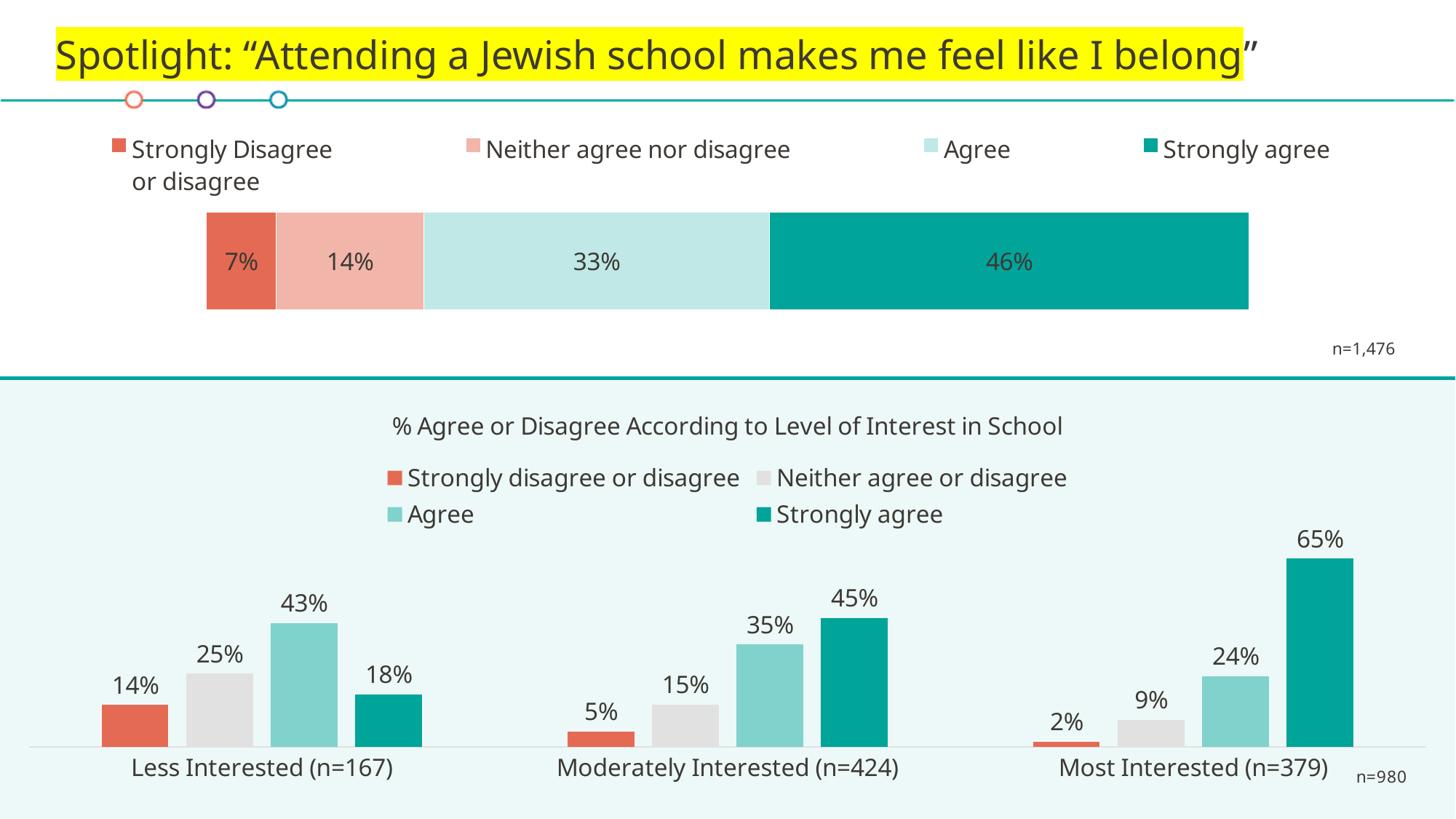
In the chart '% Agree or Disagree According to Level of Interest in School', what is the difference between the 'Strongly agree' percentages of the Most Interested and Less Interested groups? 47% In the chart '% Agree or Disagree According to Level of Interest in School', which interest group has the lowest 'Strongly disagree or disagree' percentage? Most Interested (n=379) In the top stacked bar chart, what percentage of respondents said 'Neither agree nor disagree'? 14% In the chart '% Agree or Disagree According to Level of Interest in School', what percentage of the Moderately Interested group said 'Neither agree or disagree'? 15% In the chart '% Agree or Disagree According to Level of Interest in School', what percentage of the Less Interested group said 'Agree'? 43% In the top stacked bar chart, how many response categories does the legend list? 4 In the chart '% Agree or Disagree According to Level of Interest in School', what percentage of the Most Interested group said 'Strongly agree'? 65% In the top stacked bar chart, what percentage of respondents said 'Strongly agree'? 46% In the top stacked bar chart, what is the difference between the 'Strongly agree' and 'Agree' percentages? 13% What type of chart is the '% Agree or Disagree According to Level of Interest in School' chart? Bar chart In the chart '% Agree or Disagree According to Level of Interest in School', how does the 'Strongly agree' percentage change as level of interest increases from Less Interested to Most Interested? It rises In the top stacked bar chart, which response category has the smallest share? Strongly Disagree or disagree